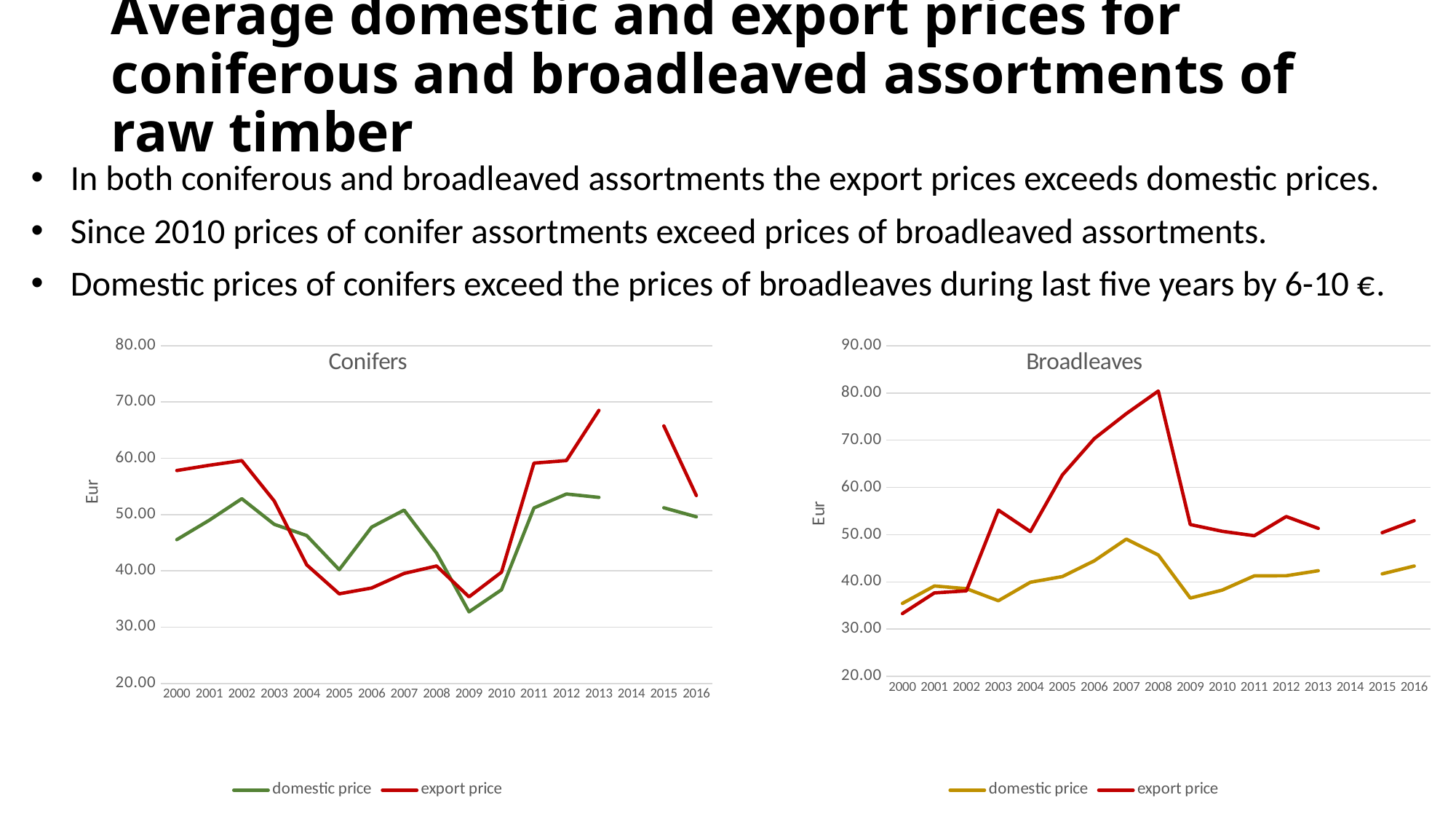
What is the label on the y axis of the Conifers chart? Eur In the Broadleaves chart, is the export price in 2000 greater or less than 40.00? less In the Conifers chart, is the domestic price in 2009 greater or less than 40.00? less What kind of chart is the Conifers chart? line chart In the Conifers chart, in which year does the export price reach its highest value? 2013 In the Broadleaves chart, which is larger in 2008, the domestic price or the export price? export price In the Broadleaves chart, in which year does the export price peak? 2008 How many years are labelled on the x axis of the Conifers chart? 17 In the Conifers chart, in which year is the domestic price lowest? 2009 How many series does the legend of the Broadleaves chart list? 2 In the Broadleaves chart, is the export price in 2008 greater or less than 70.00? greater In the Broadleaves chart, does the export price rise or fall from 2004 to 2008? rise